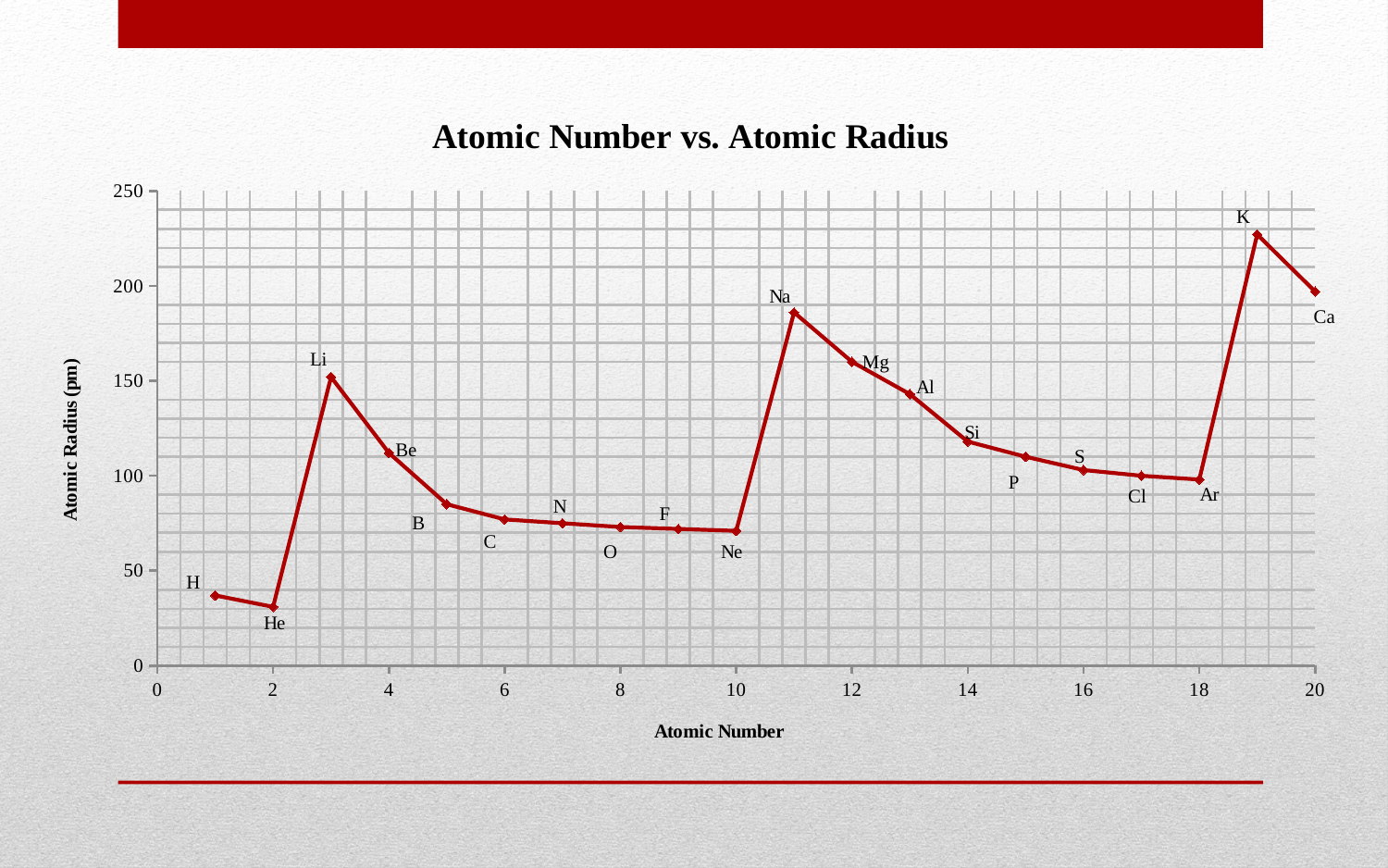
What is the label of the vertical axis? Atomic Radius (pm) Do the values rise or fall from Li (atomic number 3) to Ne (atomic number 10)? fall Is the atomic radius for H greater or less than 50? less What is the title of the chart? Atomic Number vs. Atomic Radius Is the atomic radius for Ca greater or less than 150? greater Which element has the highest atomic radius on the chart? K Is the atomic radius for Na greater or less than 150? greater Which element has the lowest atomic radius on the chart? He Which has the larger atomic radius, Na or Mg? Na How many data points are plotted on the chart? 20 What kind of chart is shown on the slide? line chart